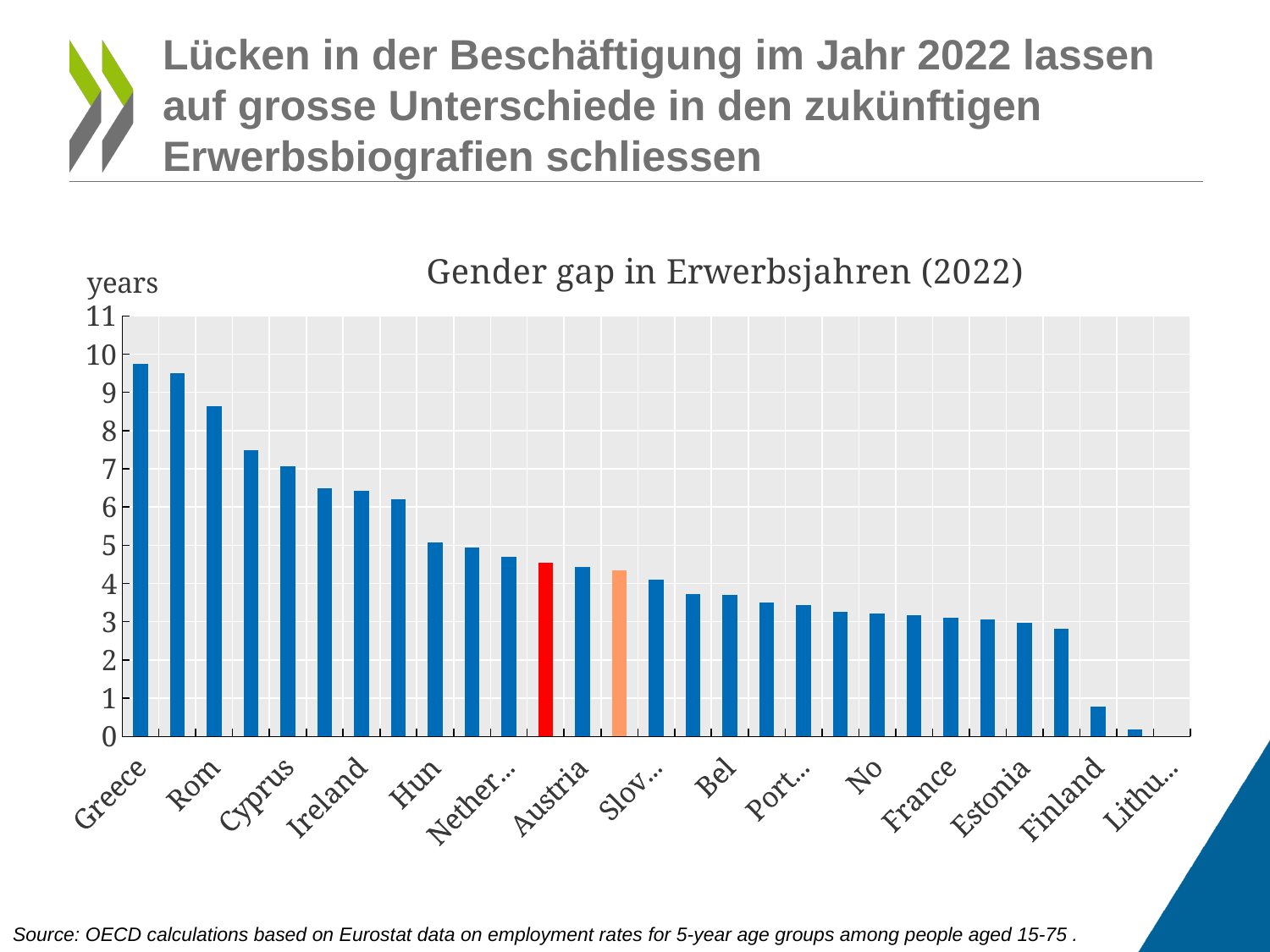
Is the value for Austria greater or less than 5? less What is the title of the chart? Gender gap in Erwerbsjahren (2022) Which country has the highest gender gap in the chart? Greece Is the value for Ireland greater or less than 6? greater What unit is shown on the y axis of the chart? years Is the value for Rom greater or less than 8? greater Do the values rise or fall from left to right along the x axis? fall Which has the larger value, Greece or Austria? Greece What kind of chart is shown on the slide? bar chart